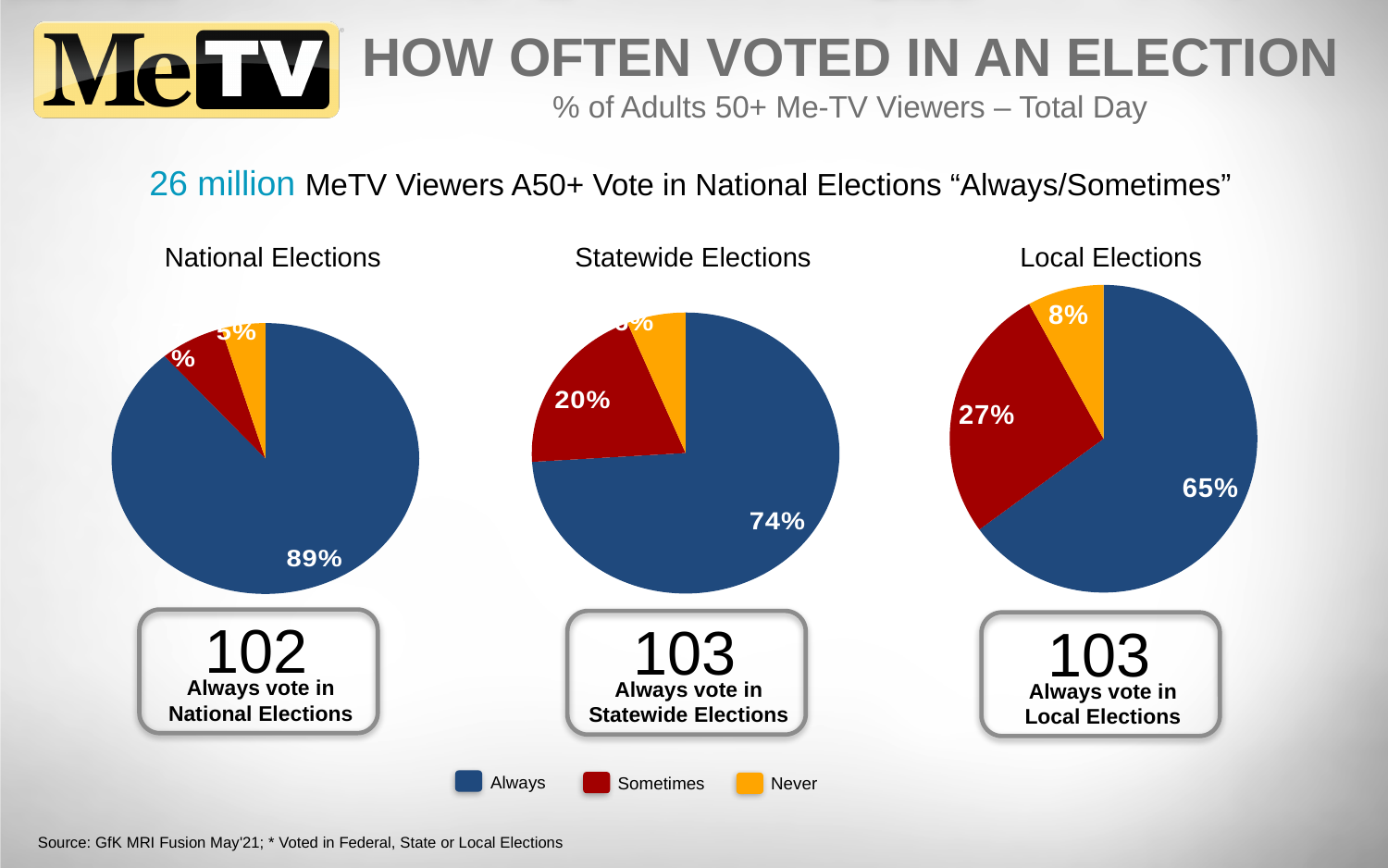
In the Local Elections pie chart, what is the difference in percentage points between the 'Always' and 'Sometimes' slices? 38 percentage points According to the legend, which colour represents 'Never'? Orange In the National Elections pie chart, what percentage of viewers say they always vote? 89% In the Statewide Elections pie chart, what percentage of viewers say they always vote? 74% How many categories does the legend list for the pie charts? 3 In the Statewide Elections pie chart, what percentage of viewers say they sometimes vote? 20% In the Local Elections pie chart, what percentage of viewers say they never vote? 8% Across the three pie charts, which election type has the largest 'Always' share? National Elections Which is larger: the 'Sometimes' share in the Statewide Elections chart or the 'Sometimes' share in the Local Elections chart? Local Elections In the Local Elections pie chart, what percentage of viewers say they always vote? 65% What type of chart is used to show how often viewers voted in each election type? Pie chart In the Local Elections pie chart, what percentage of viewers say they sometimes vote? 27%